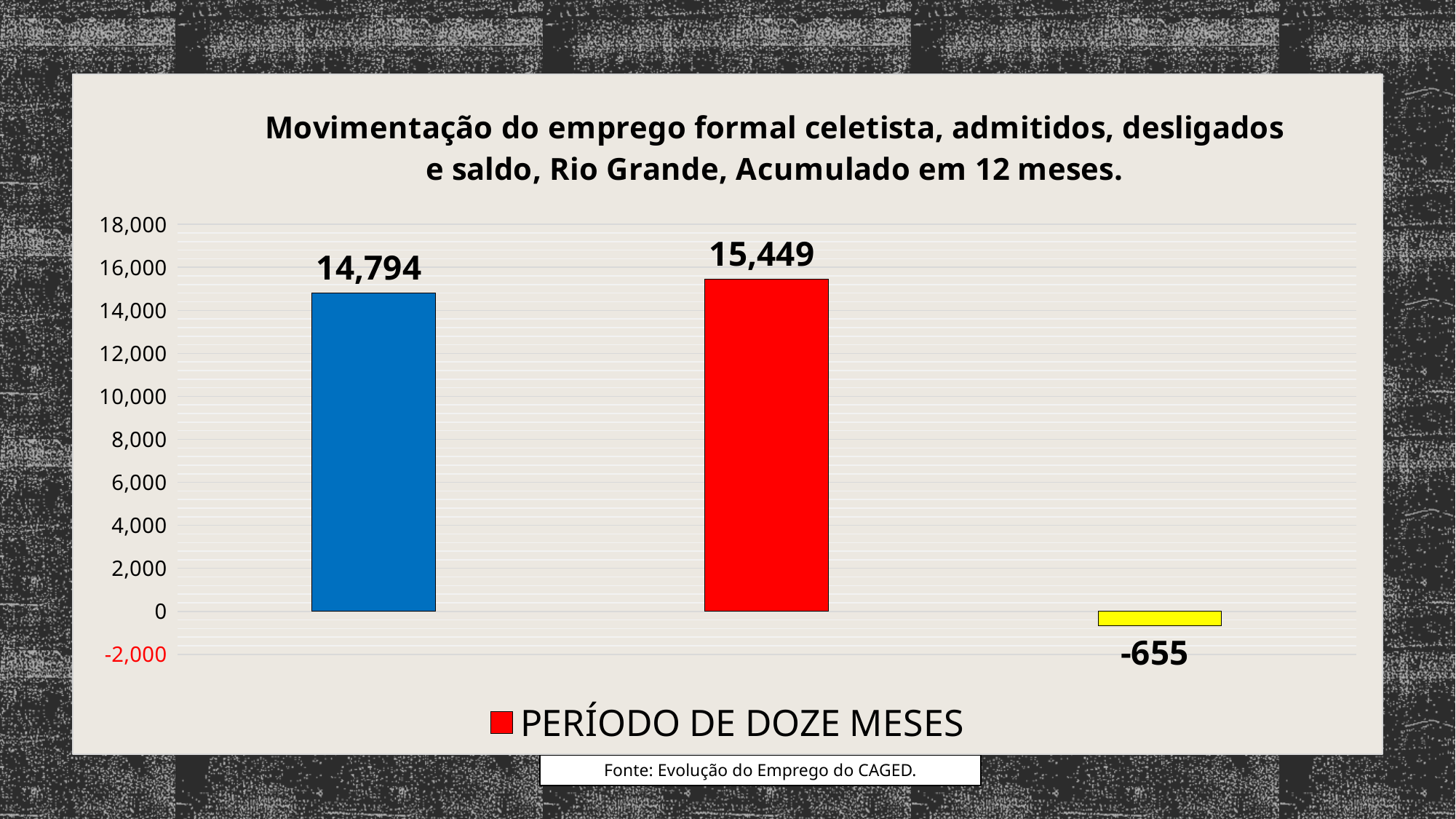
Which bar has the lowest value: the blue, red or yellow one? yellow Which is larger, the value of the blue bar or the value of the red bar? red bar What value is shown on the red bar? 15,449 What is the difference between the red bar's value and the blue bar's value? 655 What is the legend entry shown below the chart? PERÍODO DE DOZE MESES What kind of chart is shown on the slide? bar chart How many series does the legend list? 1 What value is shown on the blue bar? 14,794 How many bars are plotted in the chart? 3 What value is shown on the yellow bar? -655 Which bar has the highest value: the blue, red or yellow one? red Is the value of the blue bar greater or less than 14,000? greater